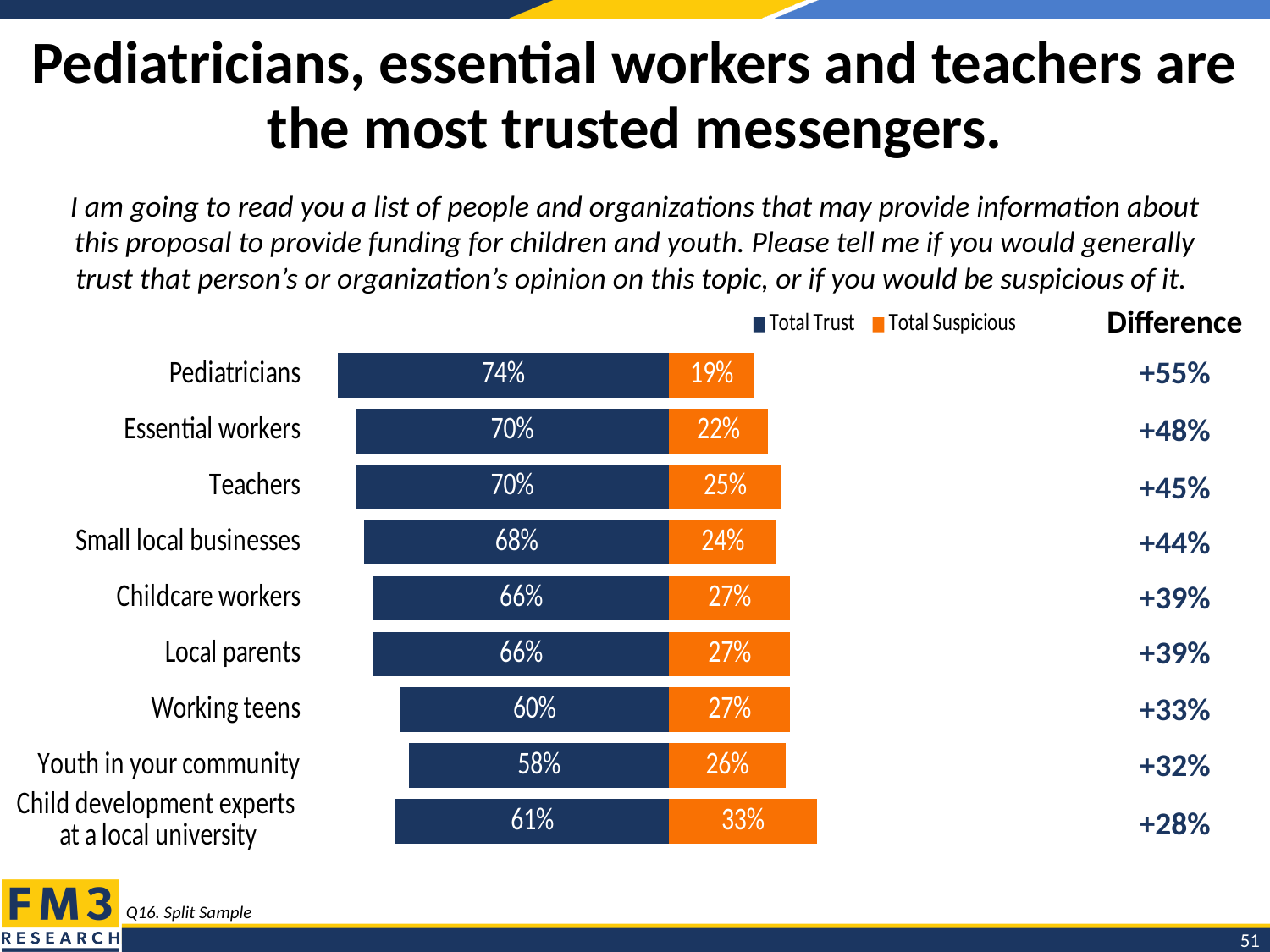
Which category has the lowest Total Suspicious value? Pediatricians What is the Total Suspicious value for Child development experts at a local university? 33% Which is larger, the Total Trust value for Small local businesses or the Total Trust value for Childcare workers? Small local businesses What kind of chart is shown on the slide? Bar chart What is the Total Trust value for Working teens? 60% How many series does the legend list? 2 Which category has the lowest Total Trust value? Youth in your community Which category has the highest Total Trust value? Pediatricians What is the Difference value shown for Essential workers? +48% What is the Total Trust value for Pediatricians? 74% How many categories are shown in the chart? 9 What is the difference between the Total Trust and Total Suspicious values for Teachers? +45%